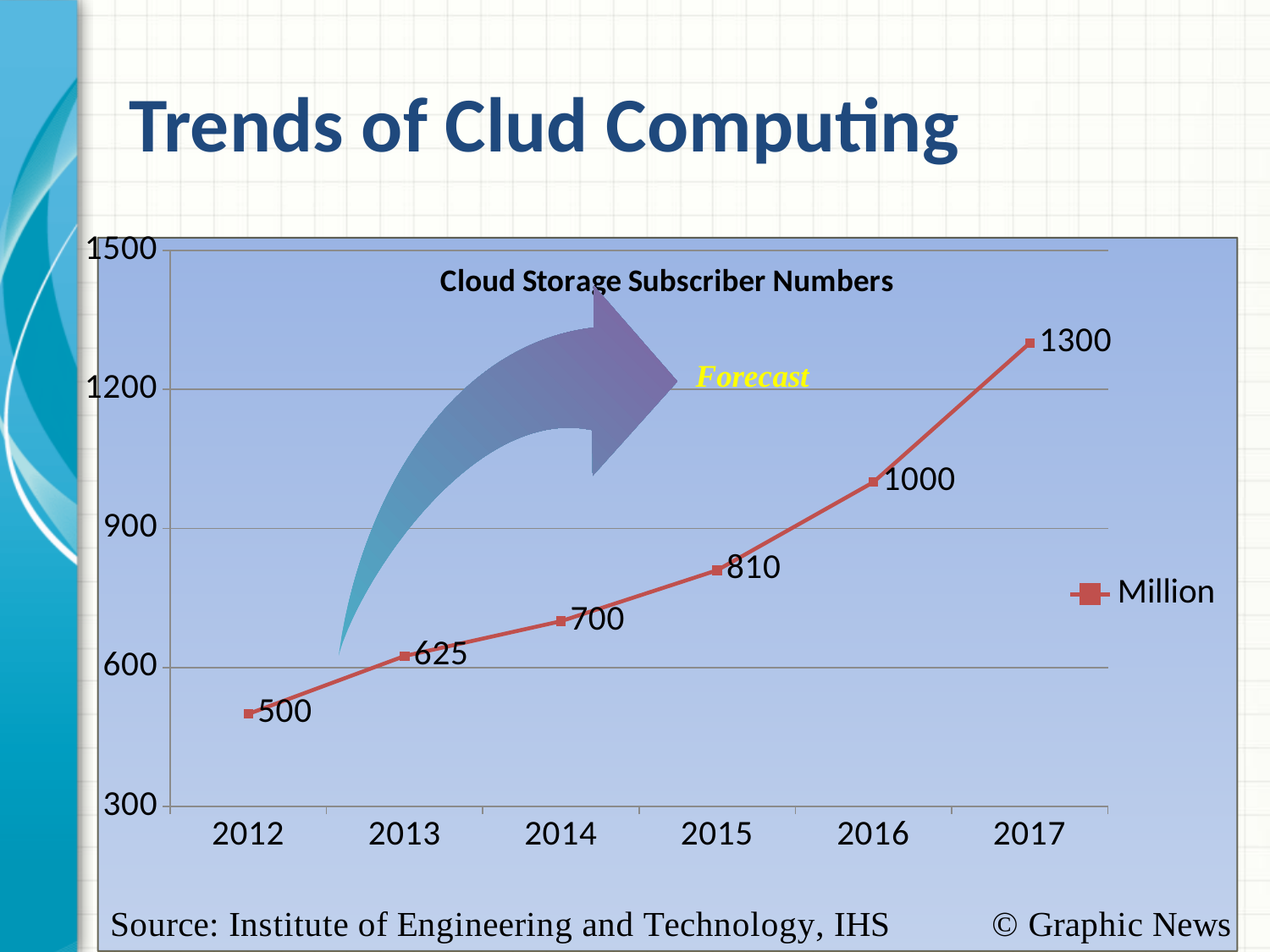
How many series does the legend list? 1 Do the values rise or fall from 2012 to 2017? rise Which year has the lowest value? 2012 What is the value for 2015? 810 What is the difference between the values for 2014 and 2013? 75 What is the value for 2017? 1300 How many data points are plotted on the chart? 6 Which year has the highest value? 2017 What kind of chart is shown? line chart What is the difference between the values for 2017 and 2016? 300 What is the value for 2012? 500 Which is larger, the value for 2014 or the value for 2015? 2015